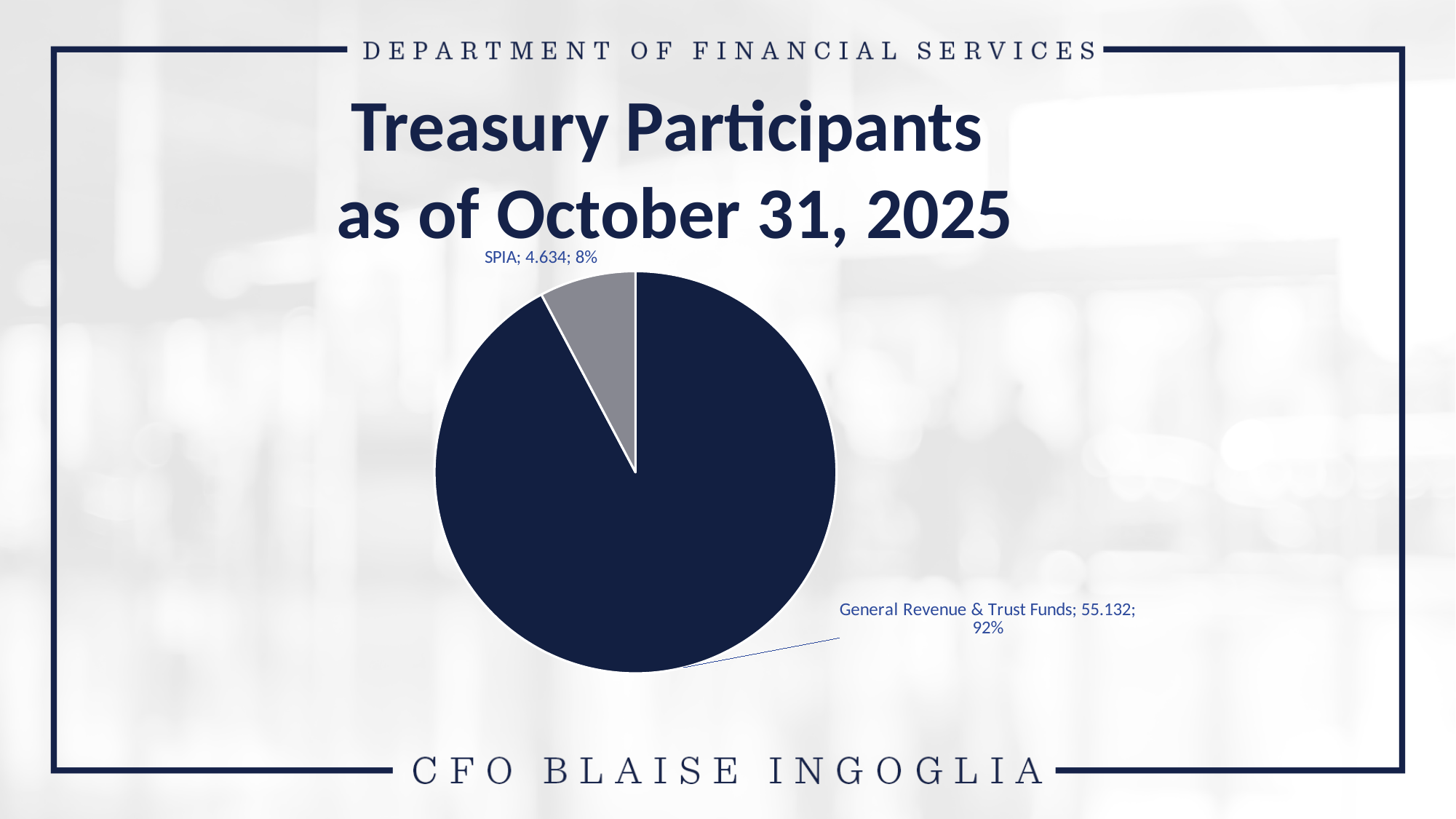
What share of the pie does SPIA represent? 8% Which is larger, the value for SPIA or the value for General Revenue & Trust Funds? General Revenue & Trust Funds What is the title of the chart on the slide? Treasury Participants as of October 31, 2025 What share of the pie does General Revenue & Trust Funds represent? 92% What colour is the SPIA slice of the pie? grey How many slices does the pie chart have? 2 What is the difference between the values for General Revenue & Trust Funds and SPIA? 50.498 Which slice of the pie is the smallest? SPIA Which slice of the pie is the largest? General Revenue & Trust Funds What kind of chart is shown on the slide? pie chart What is the value shown for General Revenue & Trust Funds? 55.132 What is the value shown for SPIA? 4.634